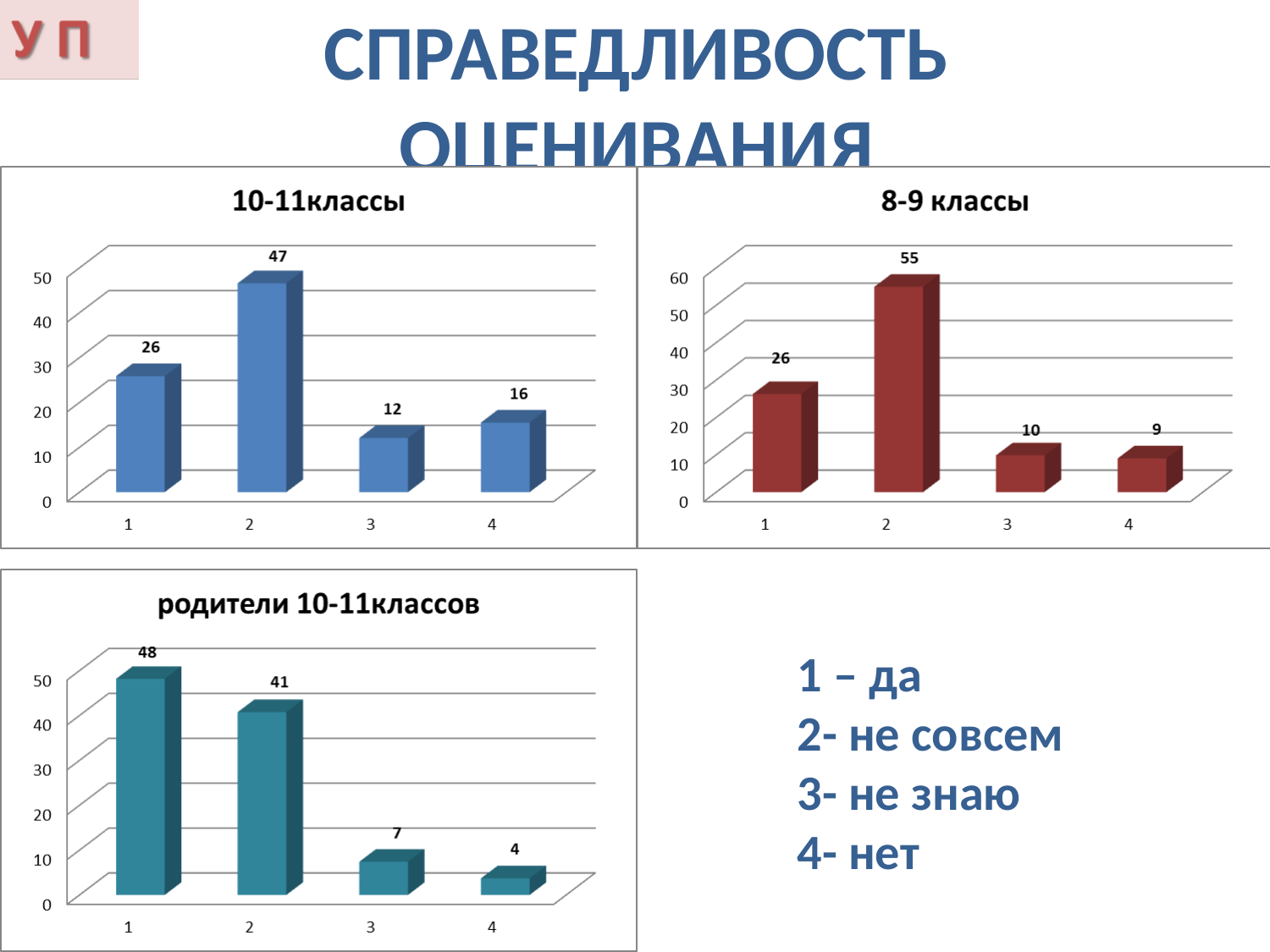
In the "родители 10-11классов" chart, what is the value for category 4? 4 In the "10-11классы" chart, is the value for category 4 greater or less than 20? less What kind of chart is the "родители 10-11классов" chart? bar chart What is the total of all four values in the "родители 10-11классов" chart? 100 In the "8-9 классы" chart, which category has the highest value? 2 In the "8-9 классы" chart, what is the difference between the values for category 3 and category 4? 1 How many categories are shown in the "8-9 классы" chart? 4 In the "родители 10-11классов" chart, which is larger: the value for category 1 or category 2? category 1 In the "10-11классы" chart, what is the value for category 2? 47 In the "10-11классы" chart, what is the difference between the values for category 2 and category 1? 21 In the "родители 10-11классов" chart, which category has the lowest value? 4 In the "8-9 классы" chart, what is the value for category 1? 26